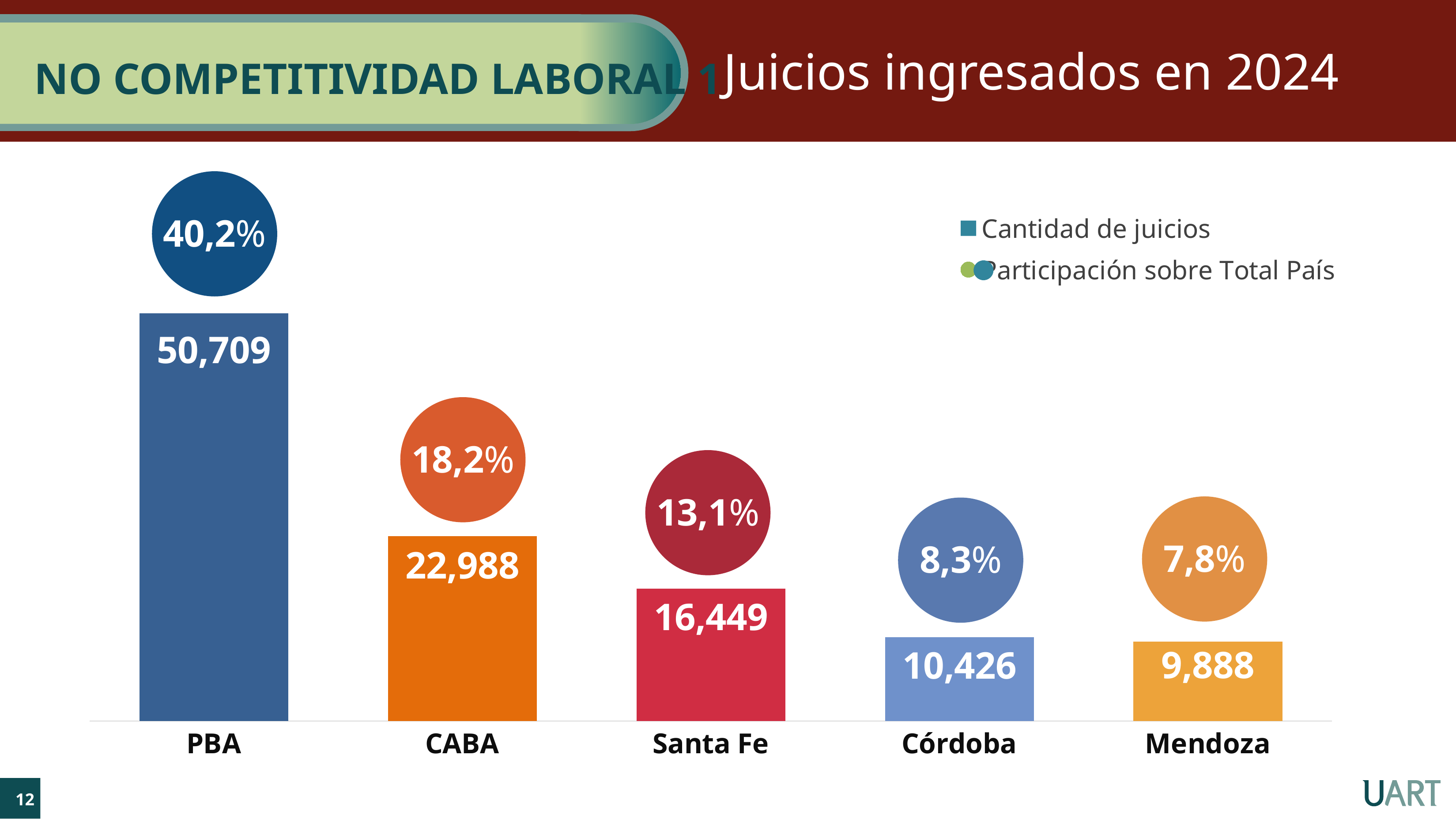
Do the Cantidad de juicios values rise or fall from PBA to Mendoza along the x axis? Fall Which category has the lowest Cantidad de juicios? Mendoza Which category has the highest Cantidad de juicios? PBA What is the Participación sobre Total País value for Mendoza? 7,8% How many series does the legend list? 2 What is the Participación sobre Total País value for CABA? 18,2% What kind of chart is shown on the slide? Bar chart What is the Cantidad de juicios value for PBA? 50,709 How many categories are shown on the x axis? 5 What is the Cantidad de juicios value for Santa Fe? 16,449 What is the difference in Cantidad de juicios between PBA and CABA? 27,721 Which has a larger Cantidad de juicios, Córdoba or Mendoza? Córdoba